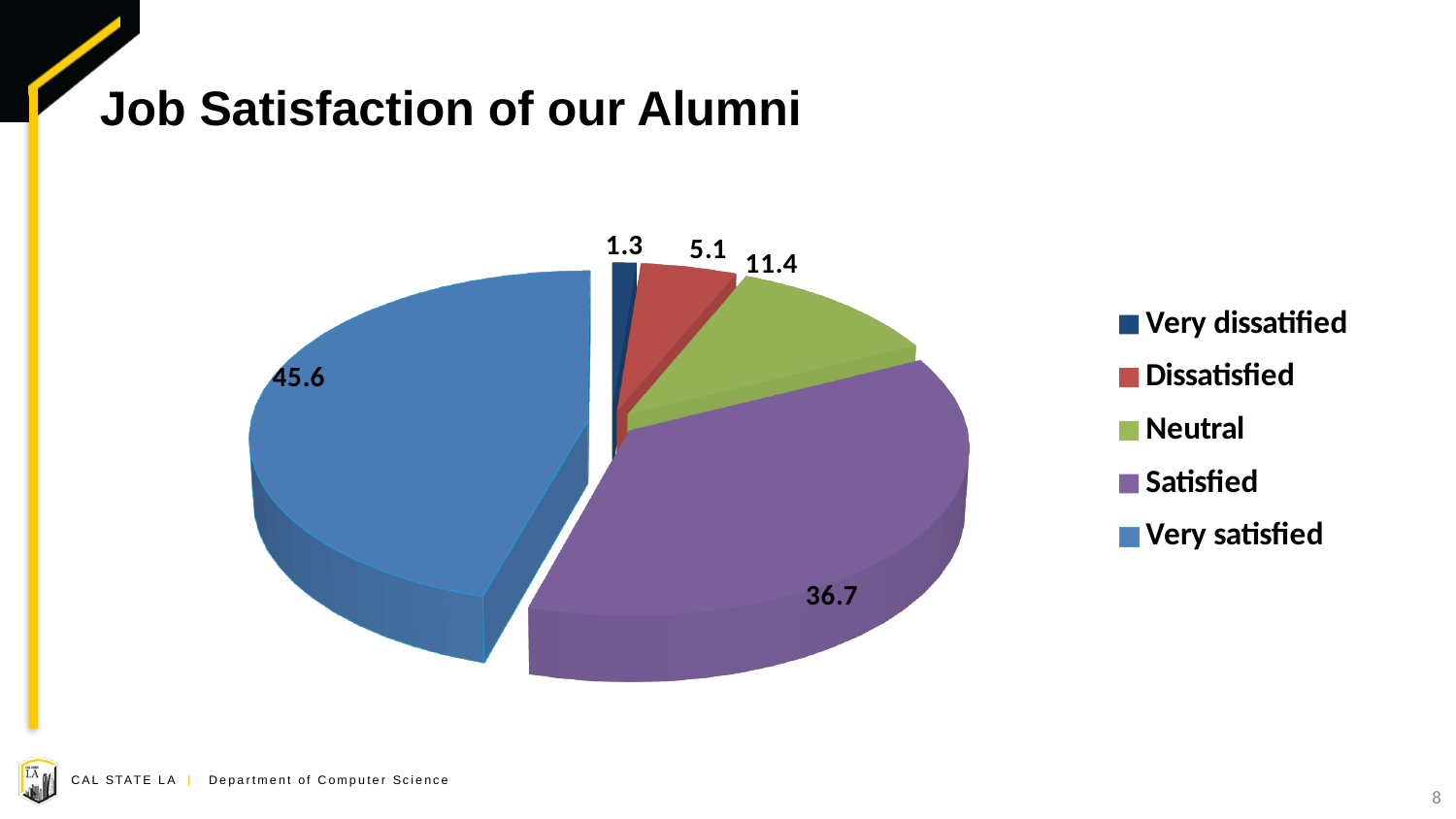
How many categories does the pie chart have? 5 Which category has the largest slice? Very satisfied Which category has the smallest slice? Very dissatisfied What is the difference between the Very satisfied and Satisfied values? 8.9 What kind of chart is shown on the slide? pie chart What is the value for the Dissatisfied slice? 5.1 What is the value for the Very satisfied slice? 45.6 What is the value for the Neutral slice? 11.4 What is the value for the Satisfied slice? 36.7 What is the title of the slide containing the chart? Job Satisfaction of our Alumni Which is larger, the Neutral value or the Dissatisfied value? Neutral What is the value for the Very dissatisfied slice? 1.3